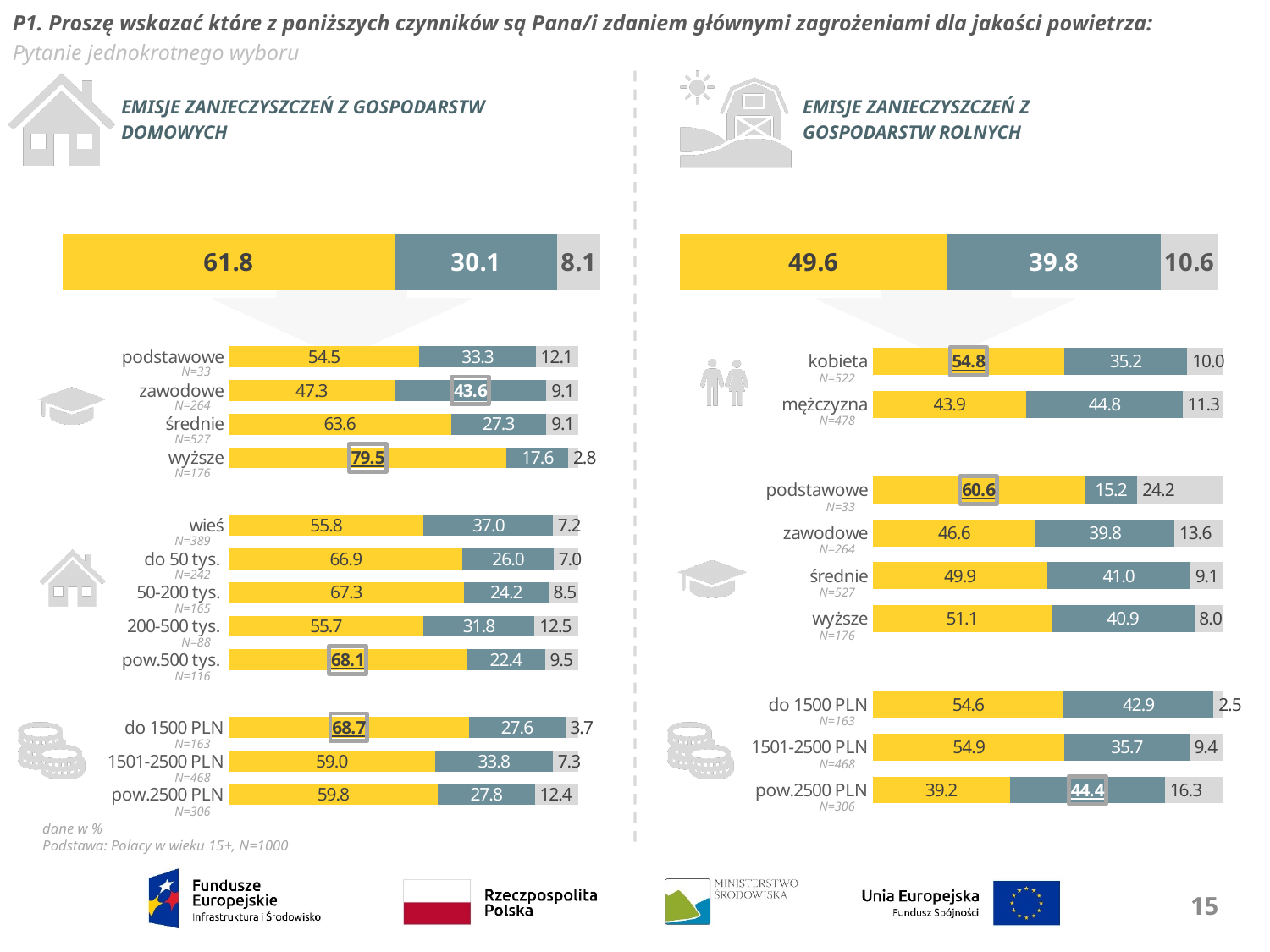
In the chart titled 'EMISJE ZANIECZYSZCZEŃ Z GOSPODARSTW ROLNYCH', which income category has the lowest yellow value? pow.2500 PLN In the chart titled 'EMISJE ZANIECZYSZCZEŃ Z GOSPODARSTW ROLNYCH', what is the yellow value for 'kobieta'? 54.8 In the chart titled 'EMISJE ZANIECZYSZCZEŃ Z GOSPODARSTW ROLNYCH', what is the total of the three segments for 'podstawowe'? 100.0 In the chart titled 'EMISJE ZANIECZYSZCZEŃ Z GOSPODARSTW ROLNYCH', which has a larger yellow value, 'kobieta' or 'mężczyzna'? kobieta In the chart titled 'EMISJE ZANIECZYSZCZEŃ Z GOSPODARSTW ROLNYCH', what is the value of the grey segment in the overall bar at the top? 10.6 In the chart titled 'EMISJE ZANIECZYSZCZEŃ Z GOSPODARSTW DOMOWYCH', how many place-of-residence categories (wieś to pow.500 tys.) are shown? 5 What type of chart is used on this slide? Stacked bar chart In the chart titled 'EMISJE ZANIECZYSZCZEŃ Z GOSPODARSTW DOMOWYCH', what is the yellow value for 'wyższe'? 79.5 In the chart titled 'EMISJE ZANIECZYSZCZEŃ Z GOSPODARSTW DOMOWYCH', what is the value of the yellow segment in the overall bar at the top? 61.8 In the chart titled 'EMISJE ZANIECZYSZCZEŃ Z GOSPODARSTW DOMOWYCH', which education category has the highest yellow value? wyższe In the chart titled 'EMISJE ZANIECZYSZCZEŃ Z GOSPODARSTW DOMOWYCH', what is the difference between the yellow values for 'wyższe' and 'podstawowe'? 25.0 In the chart titled 'EMISJE ZANIECZYSZCZEŃ Z GOSPODARSTW ROLNYCH', what is the grey value for 'pow.2500 PLN'? 16.3